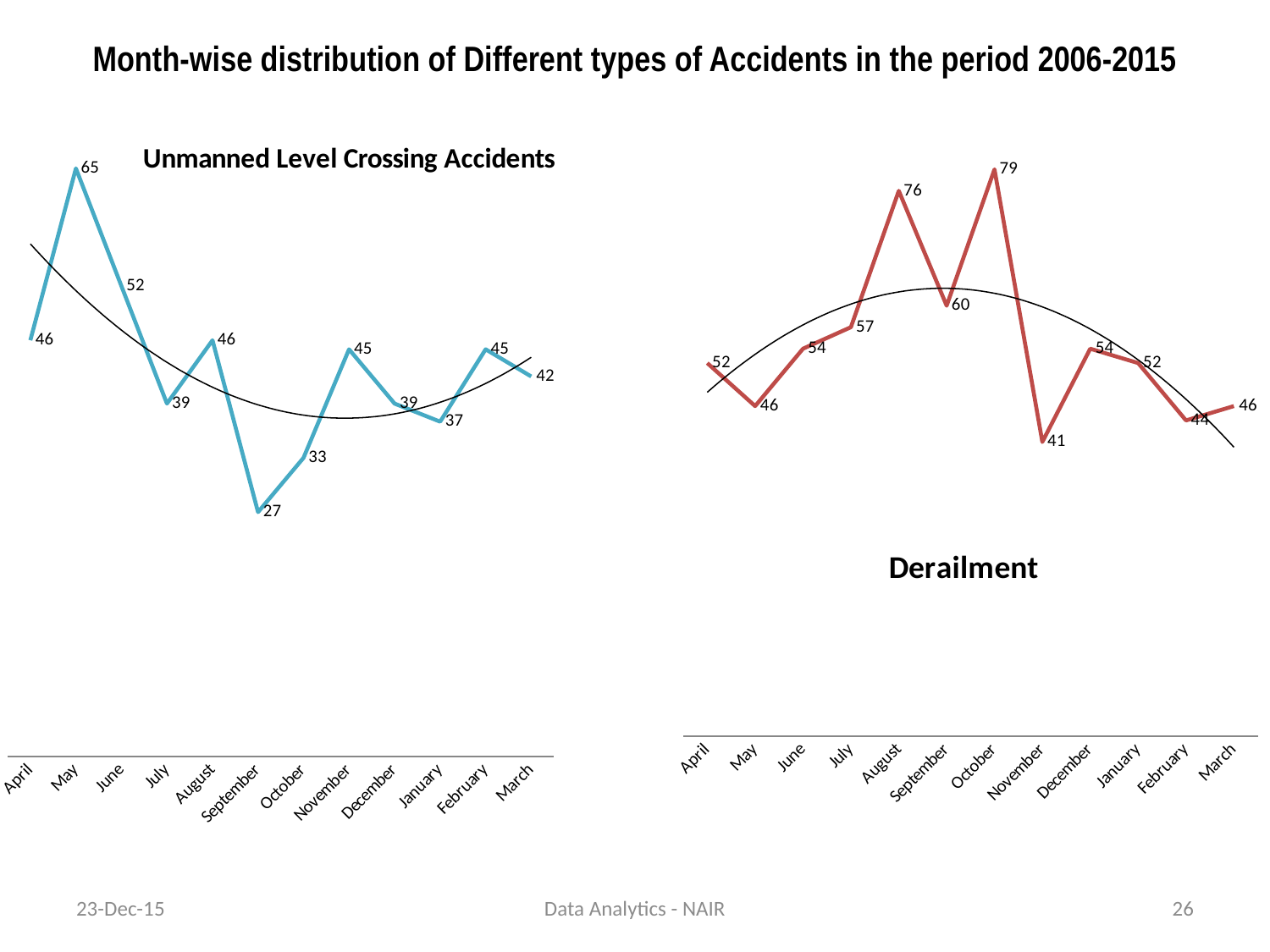
In the Derailment chart, which month has the highest value? October In the Unmanned Level Crossing Accidents chart, do the values rise or fall from May to July? Fall In the Unmanned Level Crossing Accidents chart, what is the value for January? 37 In the Derailment chart, which is larger, the value for July or the value for December? July In the Unmanned Level Crossing Accidents chart, what is the value for May? 65 In the Derailment chart, which month has the lowest value? November How many months are plotted in the Derailment chart? 12 In the Unmanned Level Crossing Accidents chart, what is the difference between the values for May and September? 38 What kind of chart is the Unmanned Level Crossing Accidents chart? Line chart In the Derailment chart, what is the value for August? 76 In the Unmanned Level Crossing Accidents chart, which month has the lowest value? September In the Derailment chart, what is the difference between the values for October and November? 38